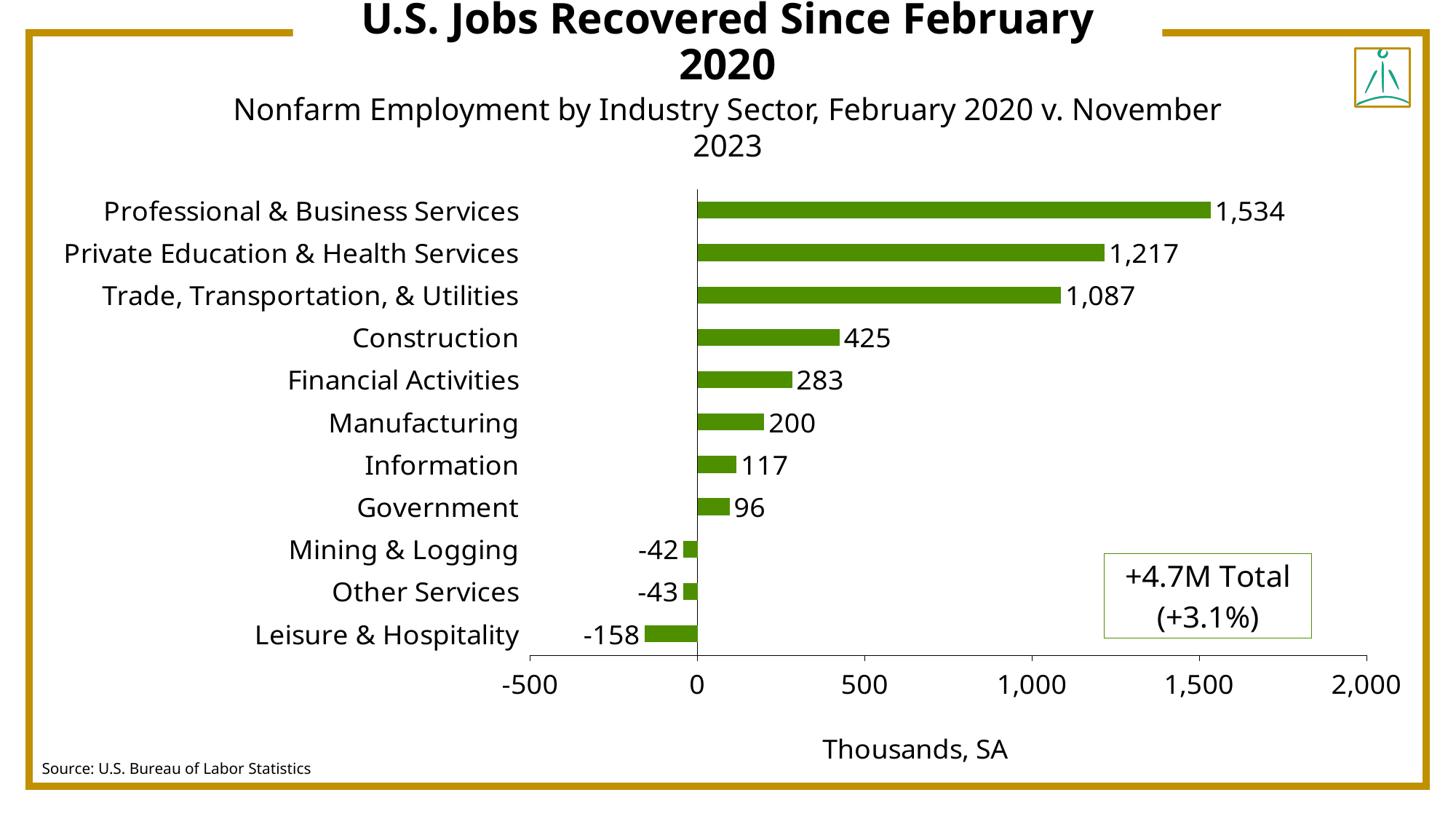
Is the value for Trade, Transportation, & Utilities greater or less than 1,000? greater What is the value for Leisure & Hospitality? -158 What is the value for Professional & Business Services? 1,534 How many industry sectors are shown in the chart? 11 What unit is shown on the x axis of the chart? Thousands, SA Which industry sector has the highest value? Professional & Business Services What is the difference between the values for Private Education & Health Services and Trade, Transportation, & Utilities? 130 What is the value for Manufacturing? 200 What total is shown in the box on the chart? +4.7M Total (+3.1%) Which is larger, the value for Construction or the value for Financial Activities? Construction What kind of chart is shown on the slide? Bar chart Which industry sector has the lowest value? Leisure & Hospitality